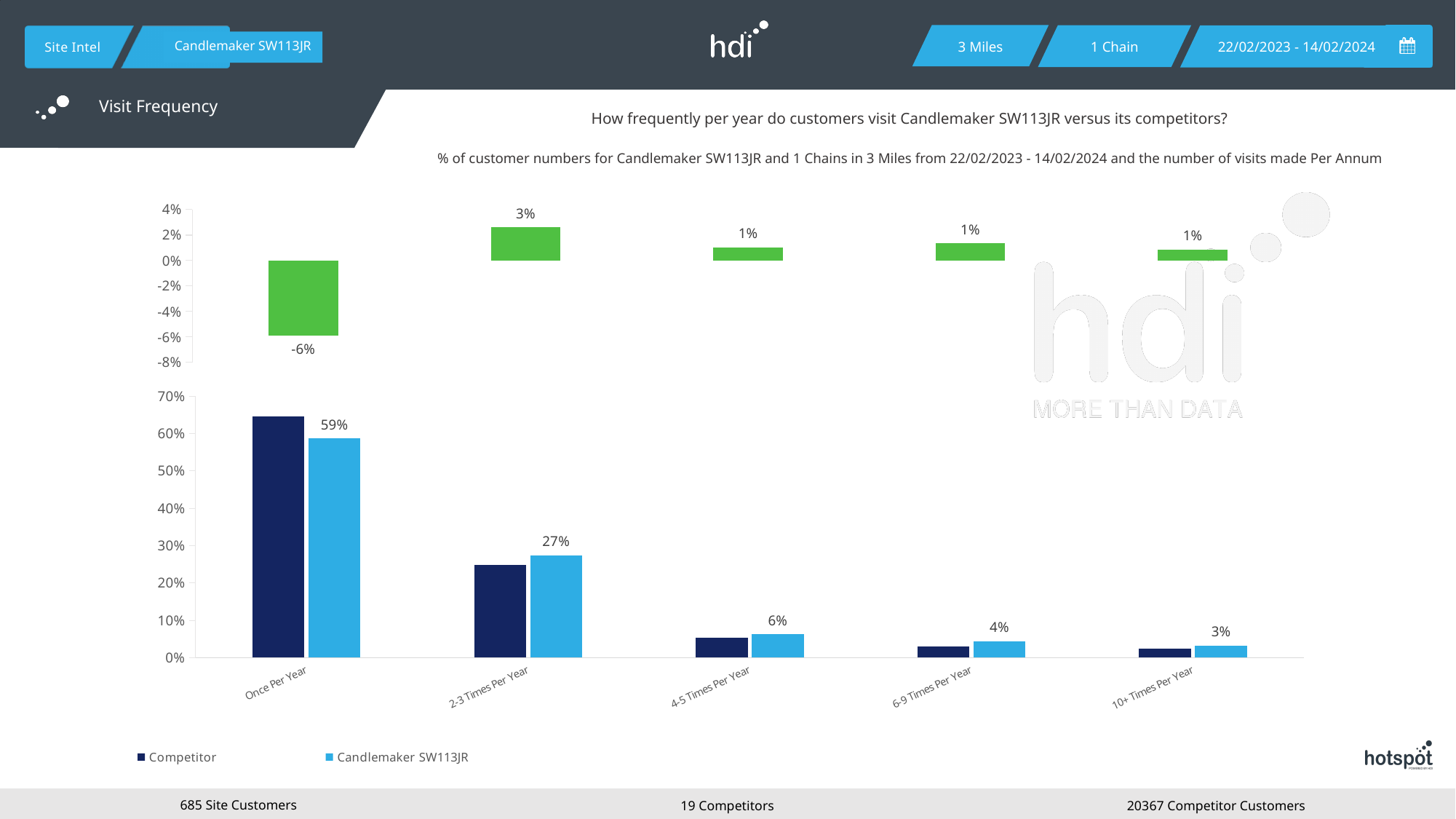
In the bottom chart, what is the difference between the Candlemaker SW113JR values for Once Per Year and 2-3 Times Per Year? 32% In the bottom chart, what is the value for Candlemaker SW113JR for 10+ Times Per Year? 3% What kind of chart is the bottom chart? Bar chart In the bottom chart, for Once Per Year, which series has the larger value: Competitor or Candlemaker SW113JR? Competitor In the top chart, what is the value shown for 2-3 Times Per Year? 3% In the bottom chart, what is the value for Candlemaker SW113JR for 2-3 Times Per Year? 27% In the bottom chart, what is the value for Candlemaker SW113JR for Once Per Year? 59% In the bottom chart, which category has the lowest value for Candlemaker SW113JR? 10+ Times Per Year How many series does the legend of the bottom chart list? 2 In the bottom chart, is the Competitor value for Once Per Year greater or less than 60%? greater In the bottom chart, which category has the highest value for Candlemaker SW113JR? Once Per Year In the top chart, what is the value shown for Once Per Year? -6%